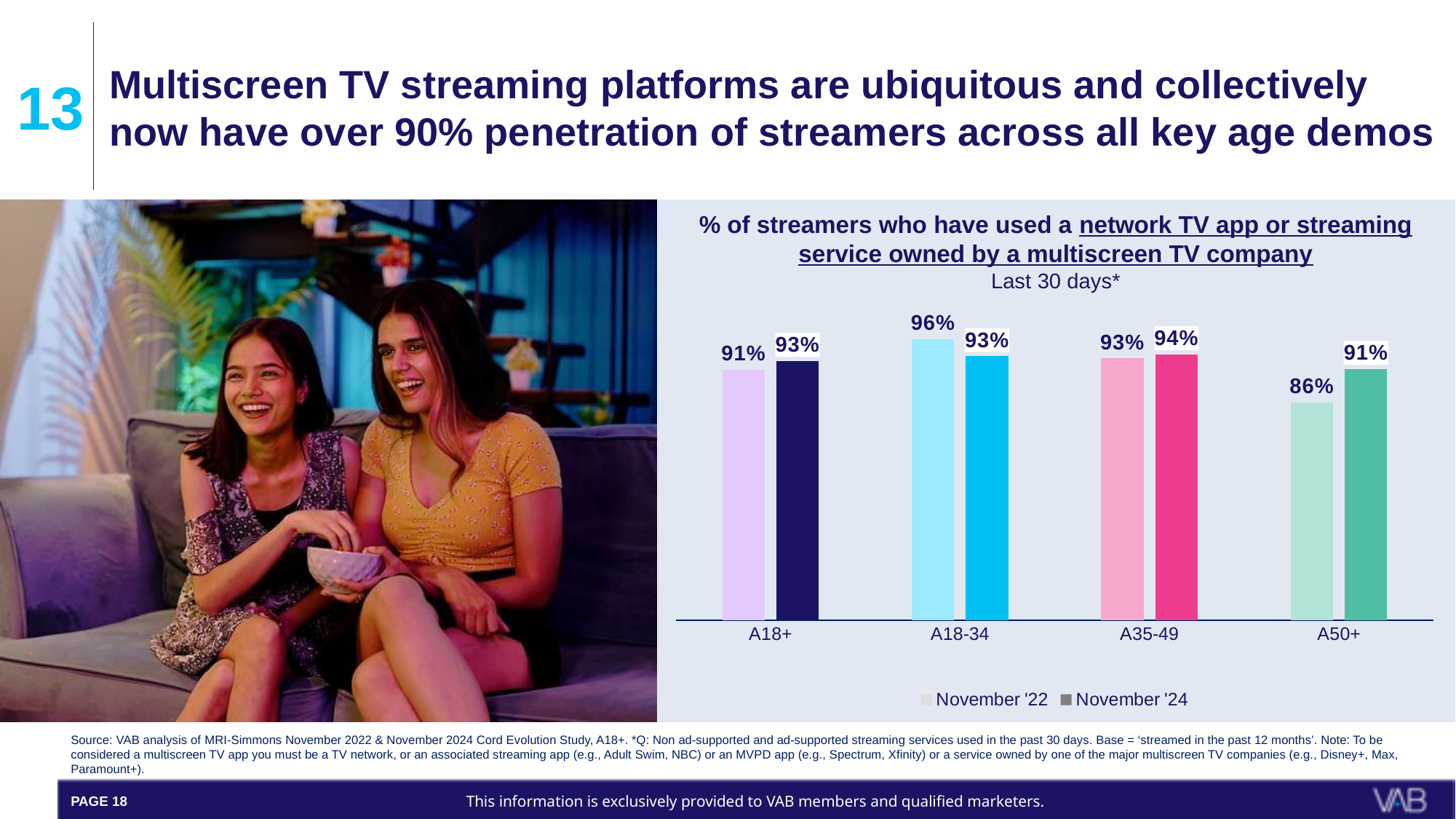
What time period does the chart subtitle specify? Last 30 days* Which is larger for A18+: the November '22 value or the November '24 value? November '24 What is the difference between the November '22 and November '24 values for A50+? 5% Which age group has the lowest November '22 value? A50+ Which age group has the highest November '22 value? A18-34 What is the November '22 value for A35-49? 93% How many age groups are shown on the x axis? 4 What is the difference between the November '22 and November '24 values for A18-34? 3% What kind of chart is shown on the slide? Bar chart How many series does the legend list? 2 What is the November '22 value for A18-34? 96% What is the November '24 value for A50+? 91%